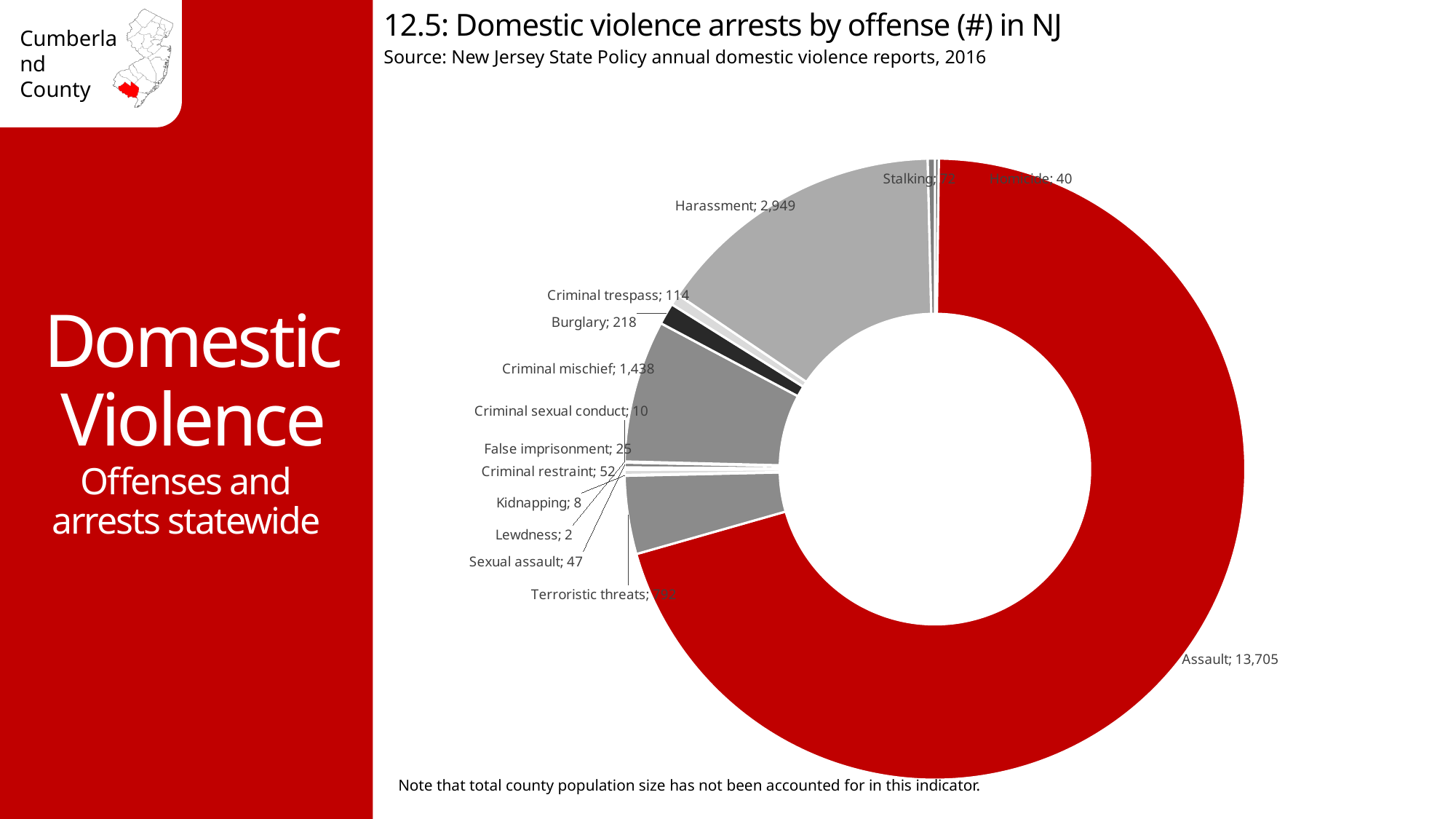
Which offense has the smallest number of arrests? Lewdness What is the value shown for Criminal mischief? 1,438 Which is larger, the value for Burglary or the value for Criminal trespass? Burglary What kind of chart is used on this slide? Doughnut (pie) chart What is the value shown for Homicide? 40 What is the value shown for Harassment? 2,949 Which offense has the largest number of arrests? Assault What is the value shown for Burglary? 218 How many domestic violence arrests for Assault are shown on the chart? 13,705 What is the difference between the Harassment and Criminal mischief values? 1,511 What is the title of the chart? 12.5: Domestic violence arrests by offense (#) in NJ How many offense categories are shown on the chart? 14